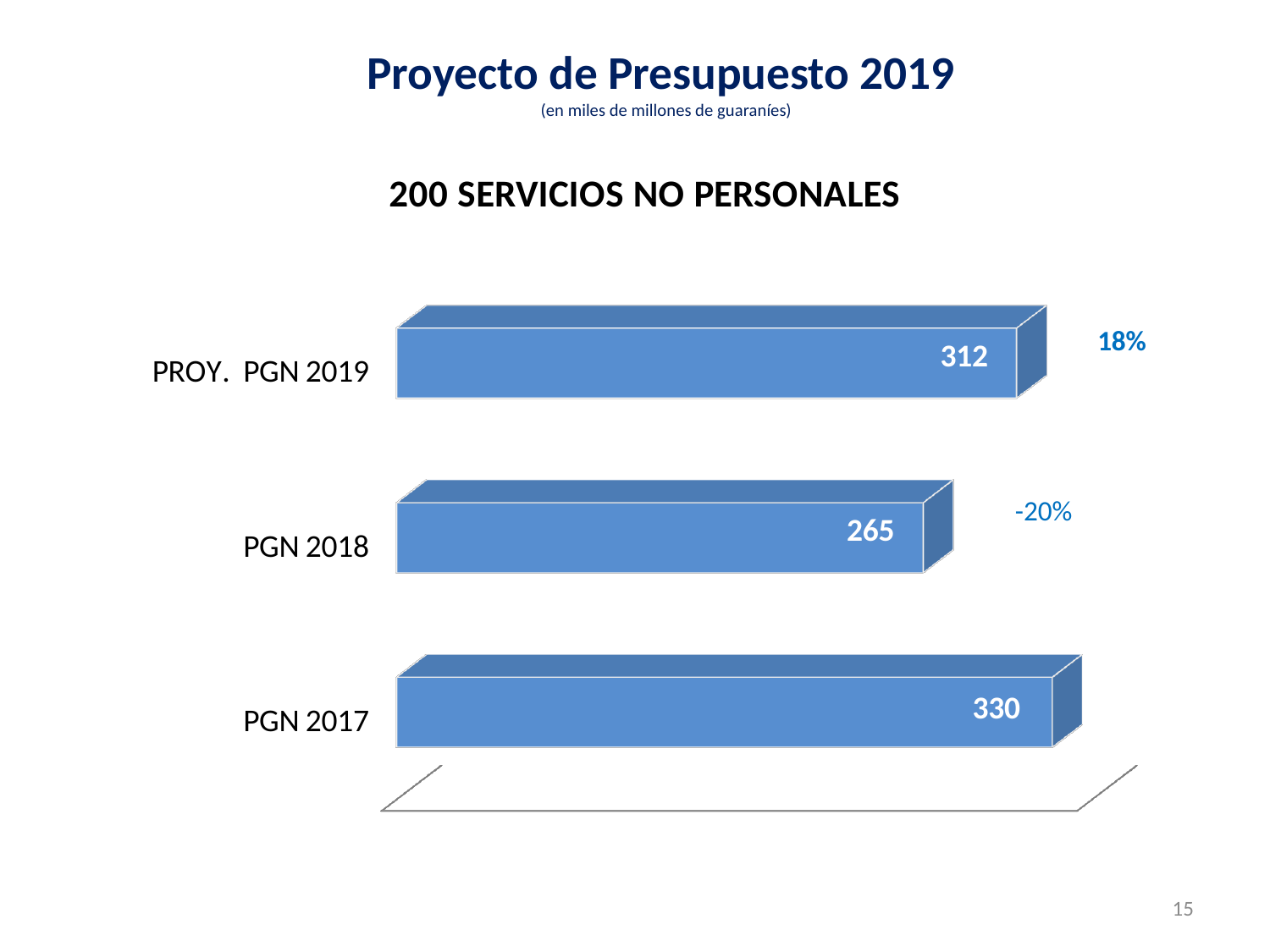
How many categories are shown in the chart? 3 What is the value for PROY. PGN 2019? 312 What is the difference between the values for PROY. PGN 2019 and PGN 2018? 47 What percentage change is shown next to the PGN 2018 bar? -20% Which category has the highest value? PGN 2017 What kind of chart is shown on the slide? Bar chart What is the title of the chart? 200 SERVICIOS NO PERSONALES Which is larger, the value for PROY. PGN 2019 or the value for PGN 2017? PGN 2017 What is the value for PGN 2017? 330 What is the value for PGN 2018? 265 What is the difference between the values for PGN 2017 and PGN 2018? 65 Which category has the lowest value? PGN 2018